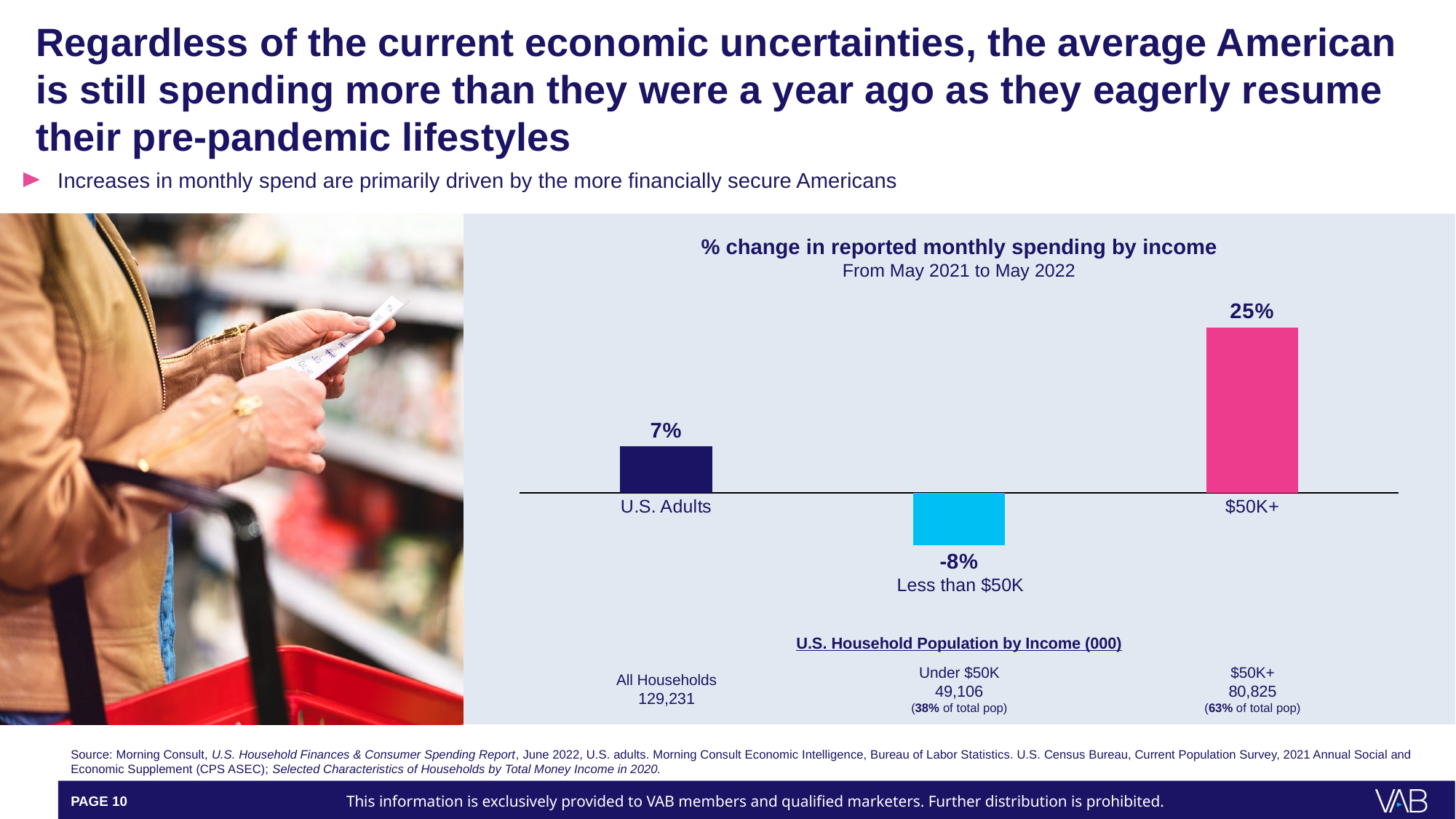
Which has a larger % change in monthly spending, U.S. Adults or Less than $50K? U.S. Adults What is the difference in percentage points between U.S. Adults and the Less than $50K group? 15 percentage points What is the % change in reported monthly spending for the $50K+ income group? 25% Which category shows the highest % change in reported monthly spending? $50K+ What is the title of the chart? % change in reported monthly spending by income What time period does the chart cover, according to its subtitle? From May 2021 to May 2022 What is the % change in reported monthly spending for U.S. Adults? 7% What is the % change in reported monthly spending for the Less than $50K income group? -8% Which category shows the lowest % change in reported monthly spending? Less than $50K How many categories are shown in the chart? 3 What is the difference in percentage points between the $50K+ group and U.S. Adults? 18 percentage points What kind of chart is shown on the slide? Bar chart